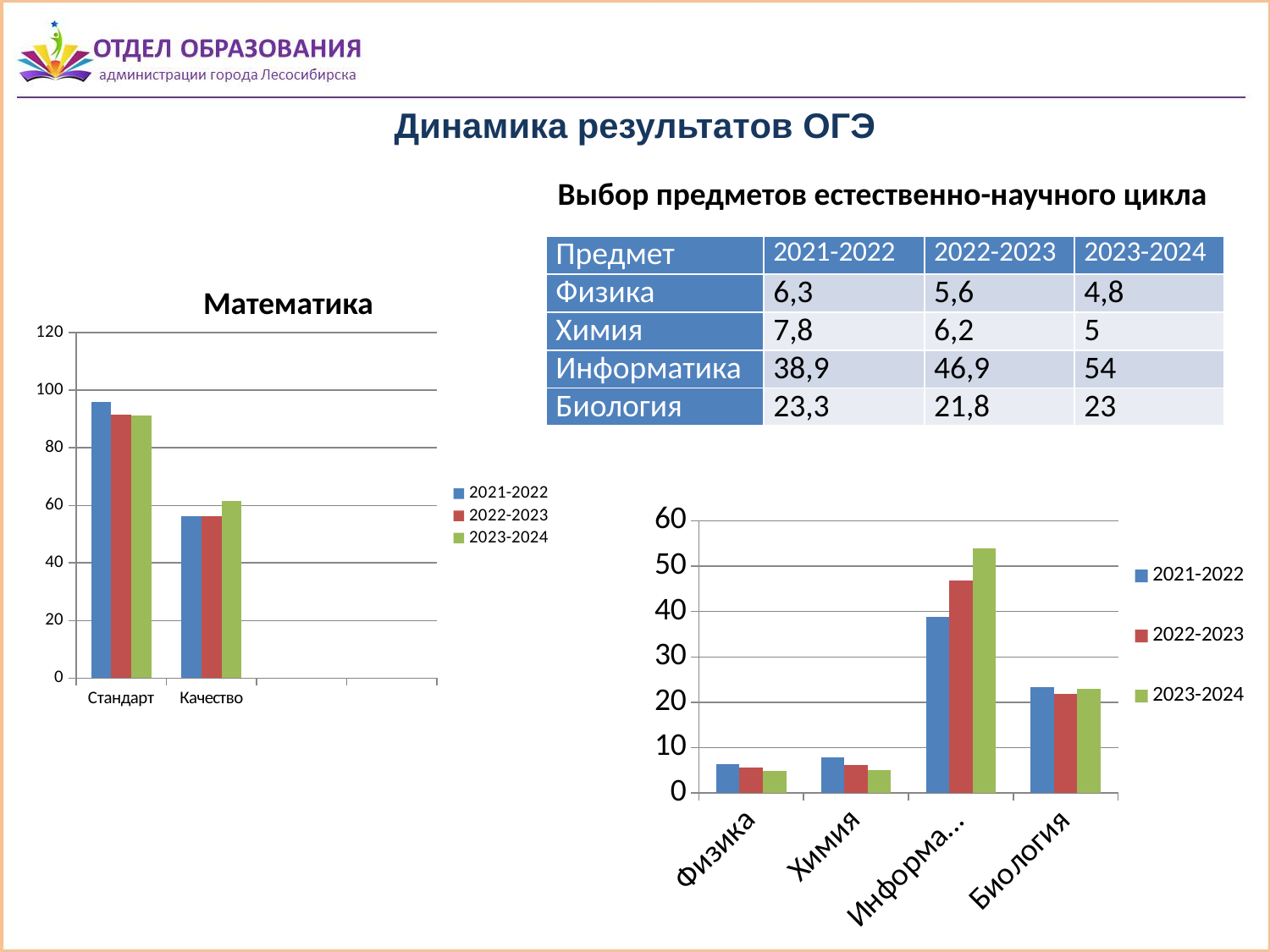
In the "Математика" chart, is the 2021-2022 value for Стандарт greater or less than 80? greater In the bottom-right chart, do the values for Физика rise or fall from 2021-2022 to 2023-2024? fall In the "Математика" chart, which category has the higher 2021-2022 value, Стандарт or Качество? Стандарт In the "Математика" chart, which series has the highest value for Качество? 2023-2024 In the "Математика" chart, is the 2023-2024 value for Качество greater or less than 80? less In the bottom-right chart, which subject has the highest values across all three years? Информатика How many categories are shown on the x axis of the bar chart at the bottom right of the slide? 4 What kind of chart is the "Математика" chart on the left of the slide? bar chart In the bottom-right chart, which subject has the lowest 2023-2024 value? Физика In the bottom-right chart, is the 2023-2024 value for Информатика greater or less than 50? greater How many series does the legend of the "Математика" chart list? 3 How many categories are shown on the x axis of the "Математика" chart? 2